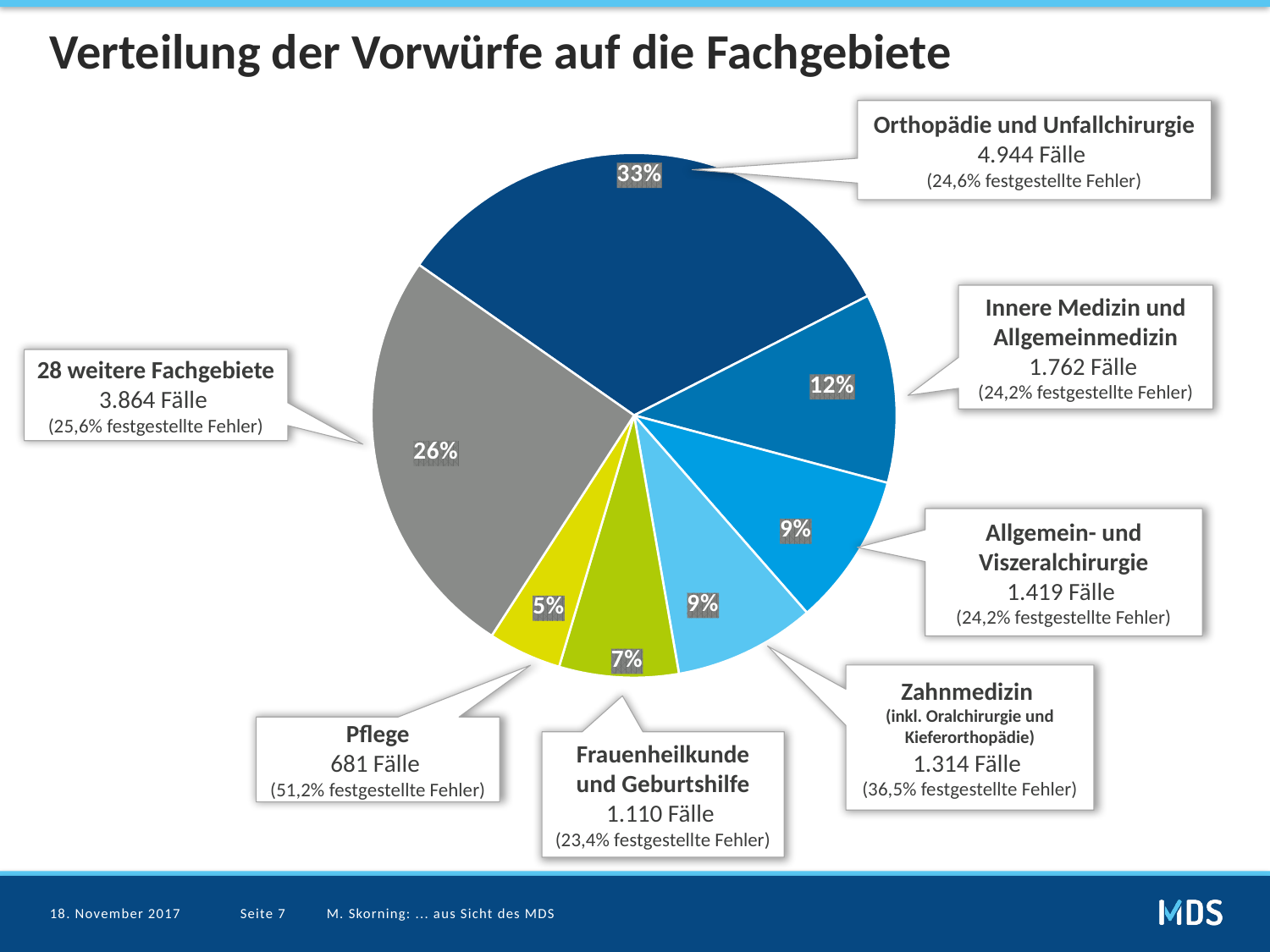
What is the difference in Fälle between Orthopädie und Unfallchirurgie and Innere Medizin und Allgemeinmedizin? 3.182 What is the title of the slide? Verteilung der Vorwürfe auf die Fachgebiete What share of the pie does 28 weitere Fachgebiete account for? 26% How many Fälle are reported for Innere Medizin und Allgemeinmedizin? 1.762 Fälle Which has more Fälle, Allgemein- und Viszeralchirurgie or Frauenheilkunde und Geburtshilfe? Allgemein- und Viszeralchirurgie How many Fälle are reported for Zahnmedizin? 1.314 Fälle What share of the pie does Orthopädie und Unfallchirurgie account for? 33% What kind of chart is shown on the slide? pie chart Which specialty has the smallest slice of the pie? Pflege Which specialty has the largest slice of the pie? Orthopädie und Unfallchirurgie What percentage of festgestellte Fehler is given for Pflege? 51,2% How many slices does the pie chart have? 7